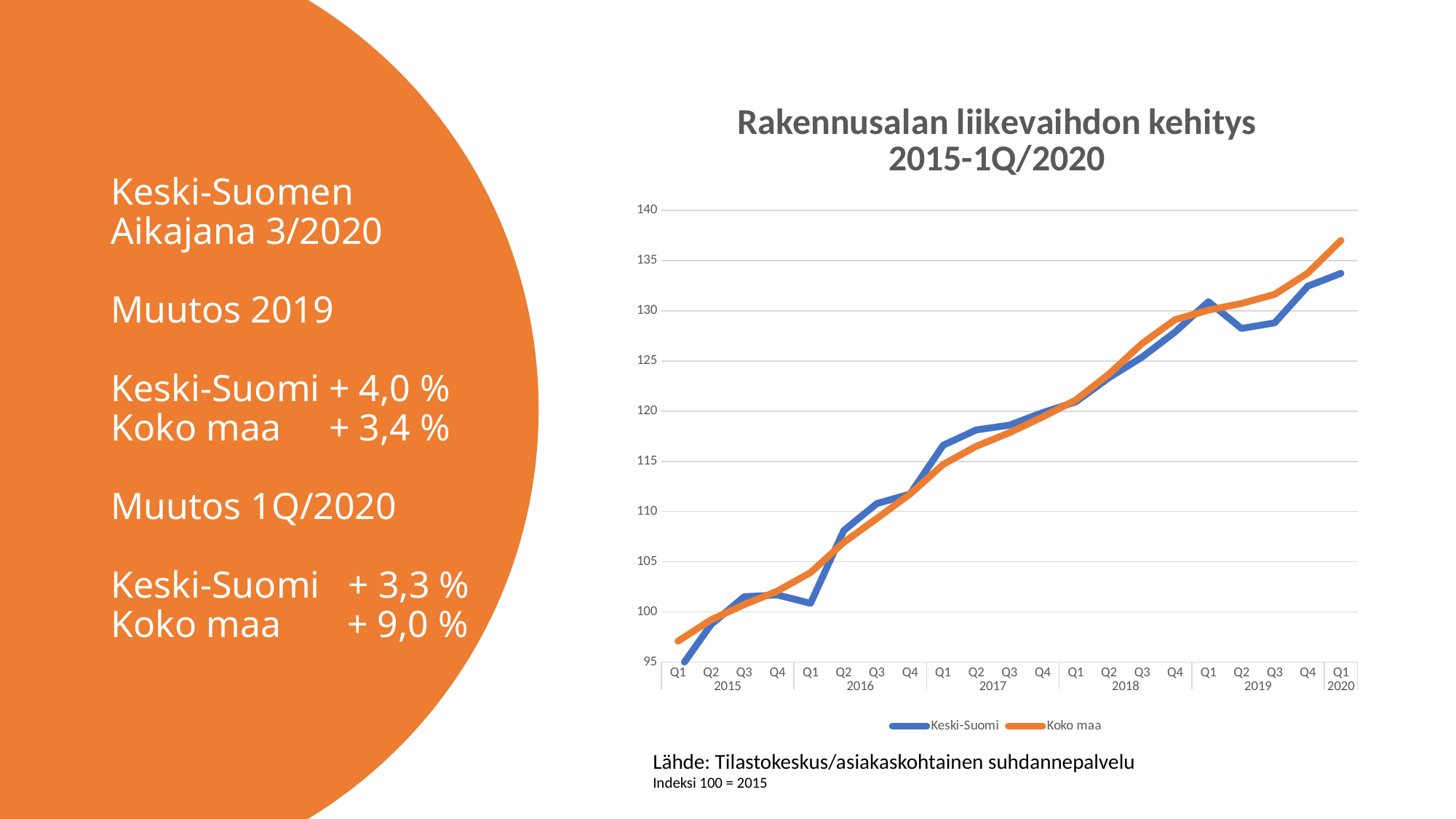
Is the value for Keski-Suomi in Q2 2019 greater or less than 130? less In which quarter does the Koko maa series reach its highest value? Q1 2020 Is the value for Koko maa in Q1 2020 greater or less than 135? greater What kind of chart is shown on the slide? line chart In Q1 2020, which series has the higher value, Keski-Suomi or Koko maa? Koko maa How many quarterly data points are plotted for each series along the x axis? 21 Do the values of the Koko maa series generally rise or fall from Q1 2015 to Q1 2020? rise In Q1 2017, which series has the higher value, Keski-Suomi or Koko maa? Keski-Suomi What is the title of the chart? Rakennusalan liikevaihdon kehitys 2015-1Q/2020 What are the two series named in the chart legend? Keski-Suomi and Koko maa Is the value for Keski-Suomi in Q1 2015 greater or less than 100? less How many series does the legend of the chart list? 2